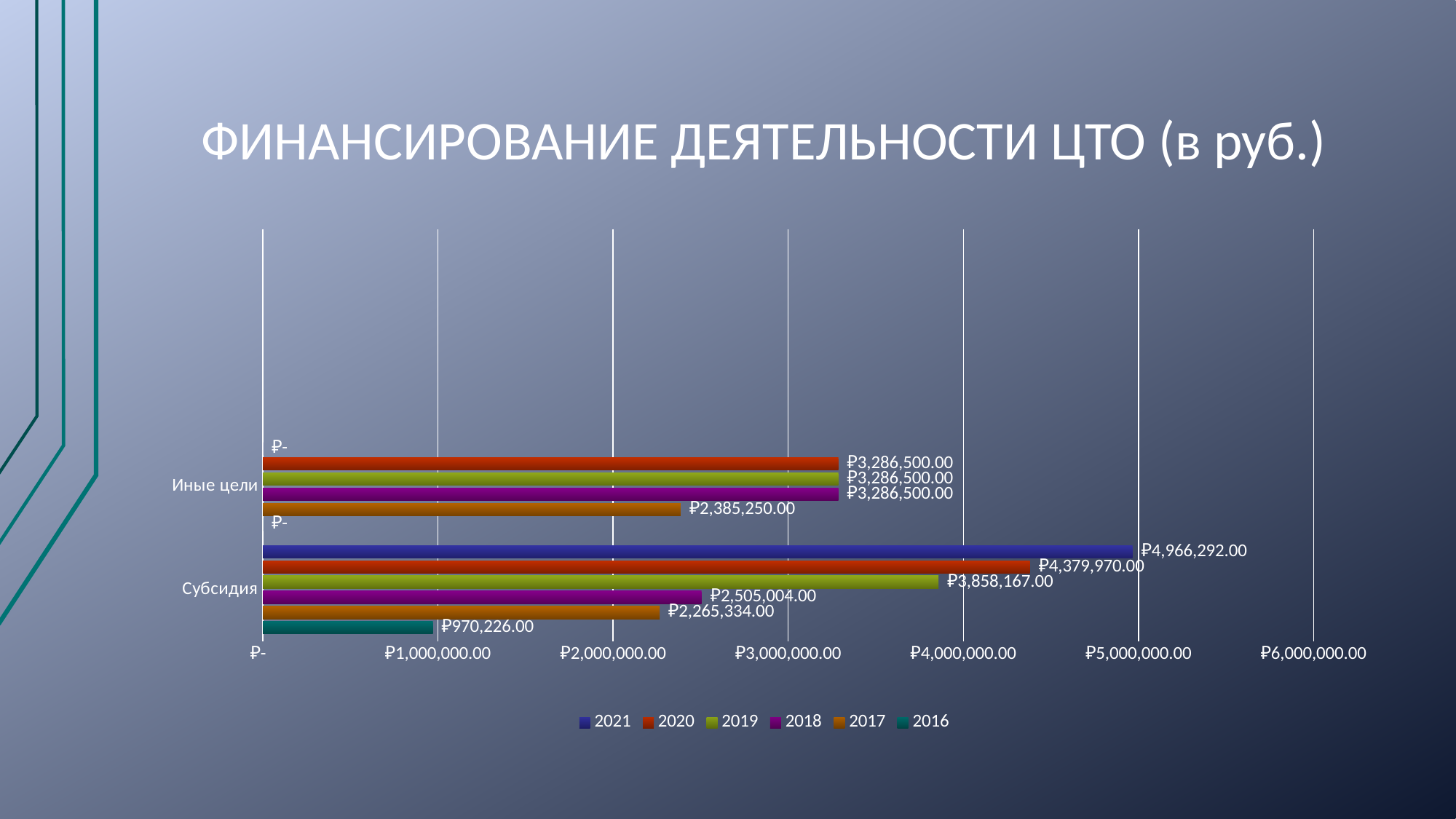
Which year has the lowest value for Субсидия? 2016 Which year has the highest value for Субсидия? 2021 What is the value for Субсидия in 2021? ₽4,966,292.00 What is the title of the chart? ФИНАНСИРОВАНИЕ ДЕЯТЕЛЬНОСТИ ЦТО (в руб.) What is the difference between the Субсидия values for 2021 and 2020? ₽586,322.00 Which is larger for 2018: the value for Субсидия or the value for Иные цели? Иные цели What is the value for Иные цели in 2020? ₽3,286,500.00 How many categories are shown on the vertical axis? 2 What kind of chart is shown on the slide? Bar chart What is the value for Субсидия in 2016? ₽970,226.00 How many series does the legend list? 6 What is the value for Иные цели in 2017? ₽2,385,250.00